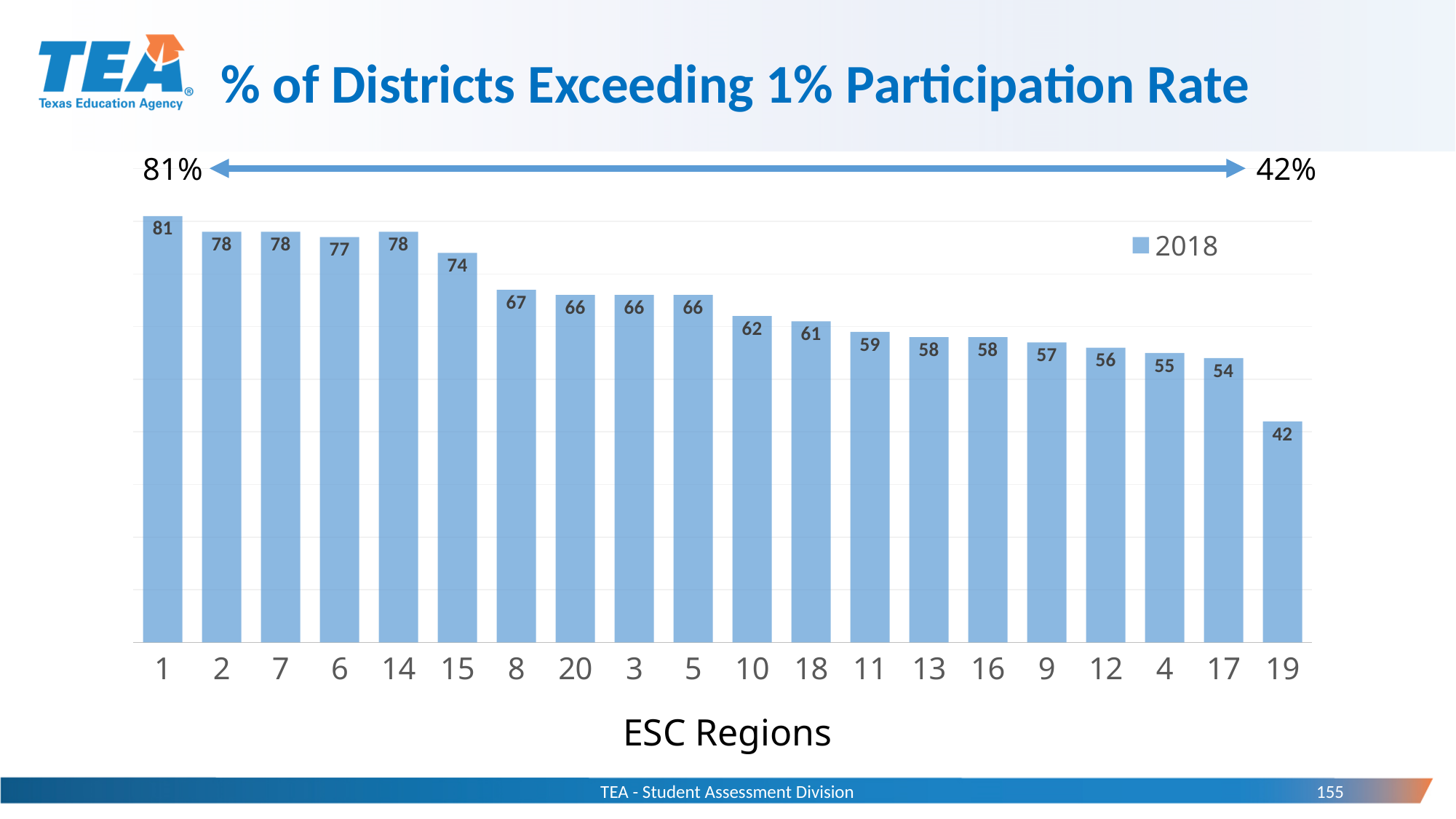
What kind of chart is shown on the slide? bar chart How many series does the legend list? 1 What is the value for ESC Region 15? 74 What is the difference between the values for ESC Region 8 and ESC Region 11? 8 What is the value for ESC Region 10? 62 How many ESC Regions are shown on the x axis? 20 Which ESC Region has the highest value? 1 Do the values rise or fall from left to right along the x axis? fall What is the difference between the values for ESC Region 1 and ESC Region 19? 39 What is the value for ESC Region 17? 54 Which has a larger value, ESC Region 6 or ESC Region 18? 6 Which ESC Region has the lowest value? 19